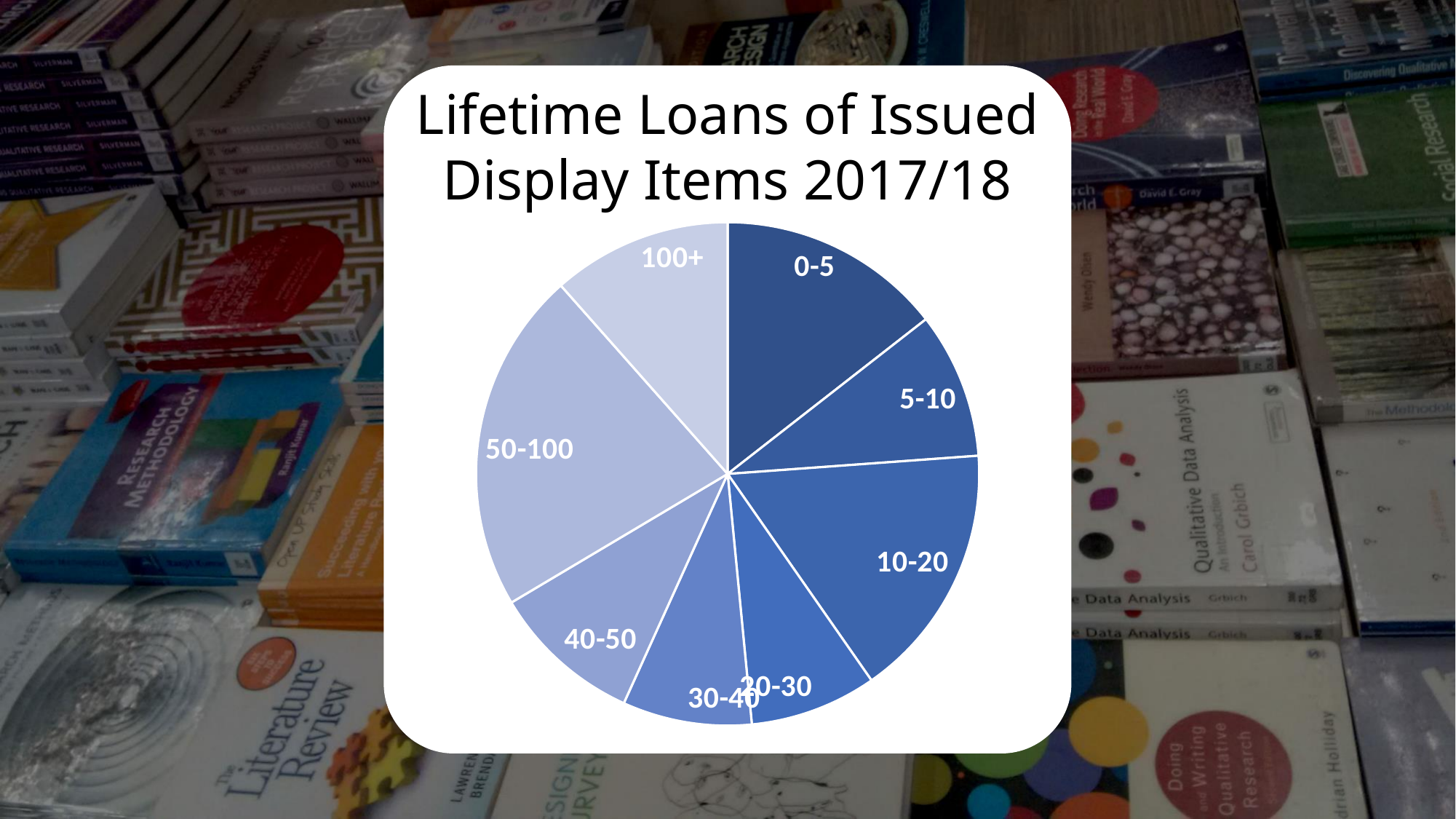
Which slice is larger, 10-20 or 20-30? 10-20 Which slice is larger, 50-100 or 0-5? 50-100 Which category has the largest slice of the pie? 50-100 Which category label appears on the slice immediately clockwise from 0-5? 5-10 Which slice is larger, 10-20 or 5-10? 10-20 What kind of chart is shown on the slide? pie chart How many slices does the pie chart have? 8 What is the title of the chart? Lifetime Loans of Issued Display Items 2017/18